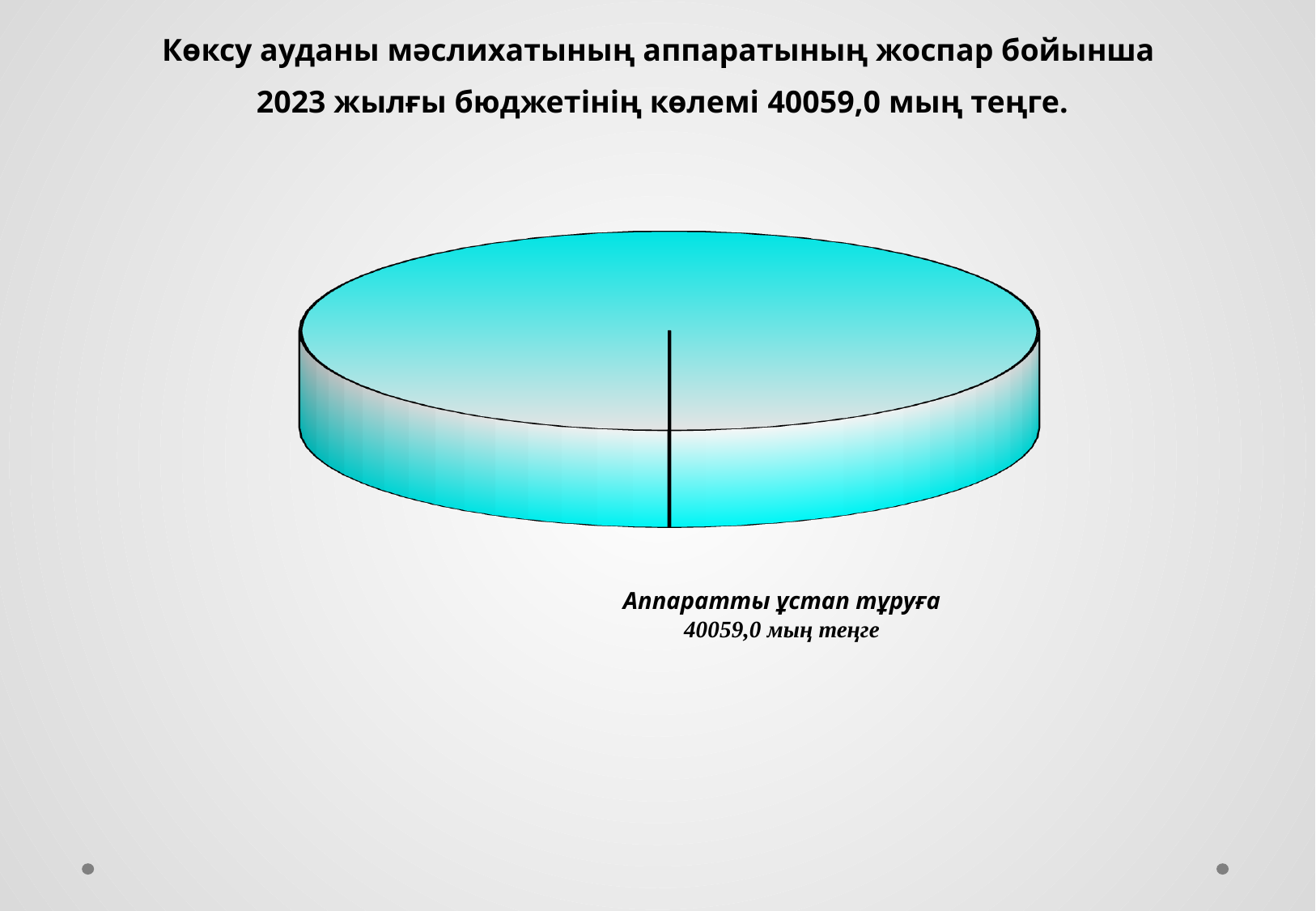
What is the label of the only category in the pie chart? Аппаратты ұстап тұруға What colour is the pie chart slice? Cyan (light blue) How many slices does the pie chart have? 1 What kind of chart is shown on the slide? Pie chart Which year does the budget shown in the chart refer to? 2023 What share of the pie does the "Аппаратты ұстап тұруға" slice take up? 100% What is the total budget amount stated in the slide title for 2023? 40059,0 мың теңге What value is shown for "Аппаратты ұстап тұруға"? 40059,0 мың теңге